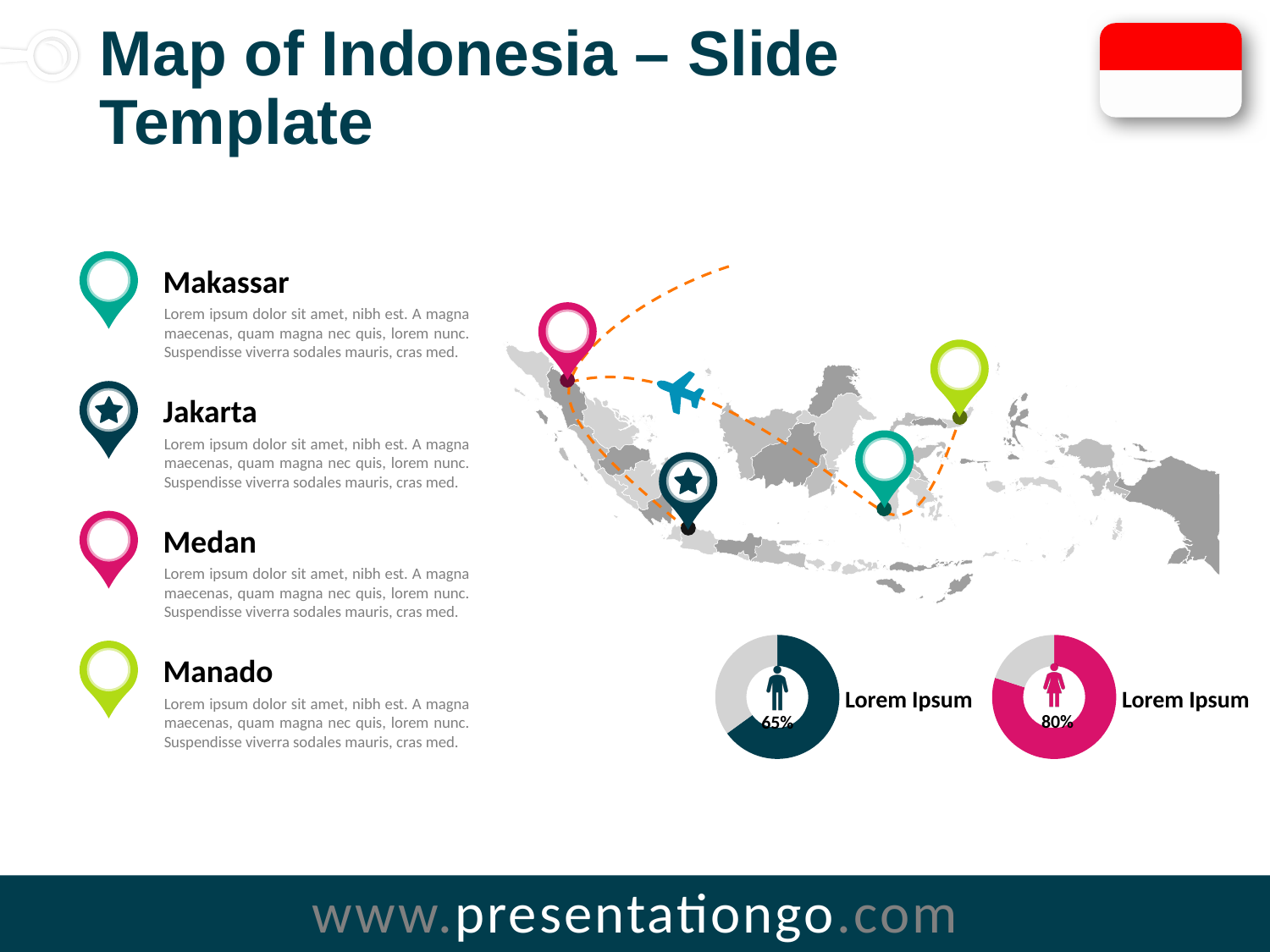
Is the value in the right donut chart greater or less than 75%? greater What label appears next to each of the two donut charts? Lorem Ipsum What kind of chart is used at the bottom of the slide to show 65% and 80%? donut chart Is the value in the left donut chart greater or less than 50%? greater What is the difference between the value in the right donut chart and the value in the left donut chart? 15 percentage points Which of the two donut charts shows the larger value, the left one or the right one? the right one What colour is the filled segment of the right donut chart? pink What value is shown in the right donut chart at the bottom of the slide? 80% What value is shown in the left donut chart at the bottom of the slide? 65% How many donut charts are shown on the slide? 2 What share of the left donut chart is filled by the dark teal segment? 65% What share of the right donut chart is filled by the pink segment? 80%